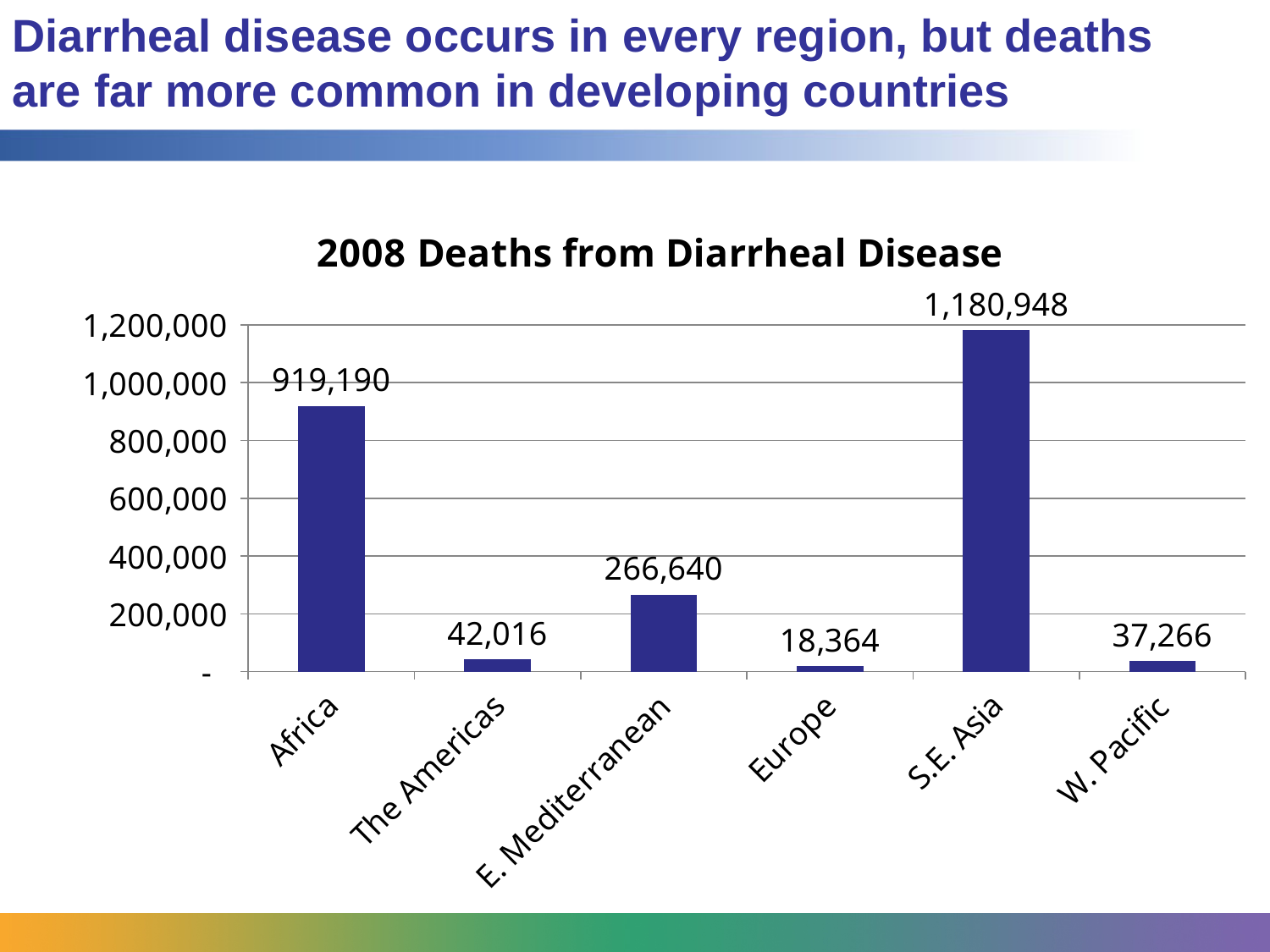
Is the value for Africa greater or less than 800,000? greater What is the difference between the values for S.E. Asia and Africa? 261,758 Which has a larger value, The Americas or E. Mediterranean? E. Mediterranean What is the value shown for E. Mediterranean? 266,640 What type of chart is shown on the slide? Bar chart Which region has the highest number of deaths from diarrheal disease? S.E. Asia How many regions are shown in the chart? 6 How many deaths from diarrheal disease are shown for Europe? 18,364 What is the difference between the values for The Americas and W. Pacific? 4,750 Which region has the lowest number of deaths from diarrheal disease? Europe What is the value shown for W. Pacific? 37,266 What is the value for S.E. Asia in the 2008 Deaths from Diarrheal Disease chart? 1,180,948